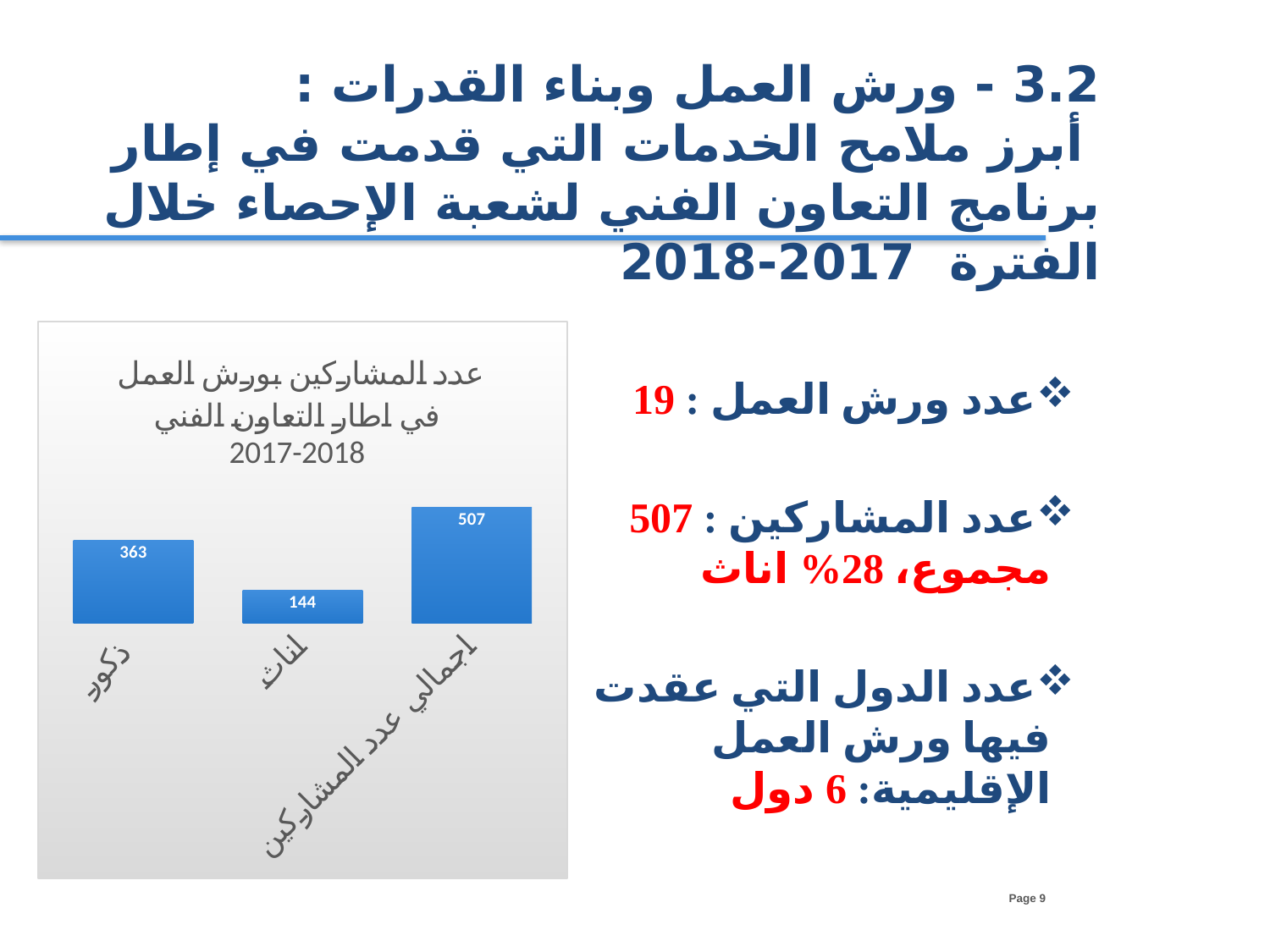
What is the value for اجمالي عدد المشاركين (total participants) in the chart? 507 Which category has the highest value in the chart? اجمالي عدد المشاركين Which is larger, the value for ذكور or the value for اناث? ذكور What period is mentioned in the chart title? 2017-2018 What is the difference between the values for ذكور and اناث? 219 Which category has the lowest value in the chart? اناث What is the value for اناث (females) in the chart? 144 What colour are the bars in the chart? Blue How many categories are shown in the chart? 3 What is the value for ذكور (males) in the chart? 363 What type of chart is shown on the slide? Bar chart What is the difference between the values for اجمالي عدد المشاركين and ذكور? 144